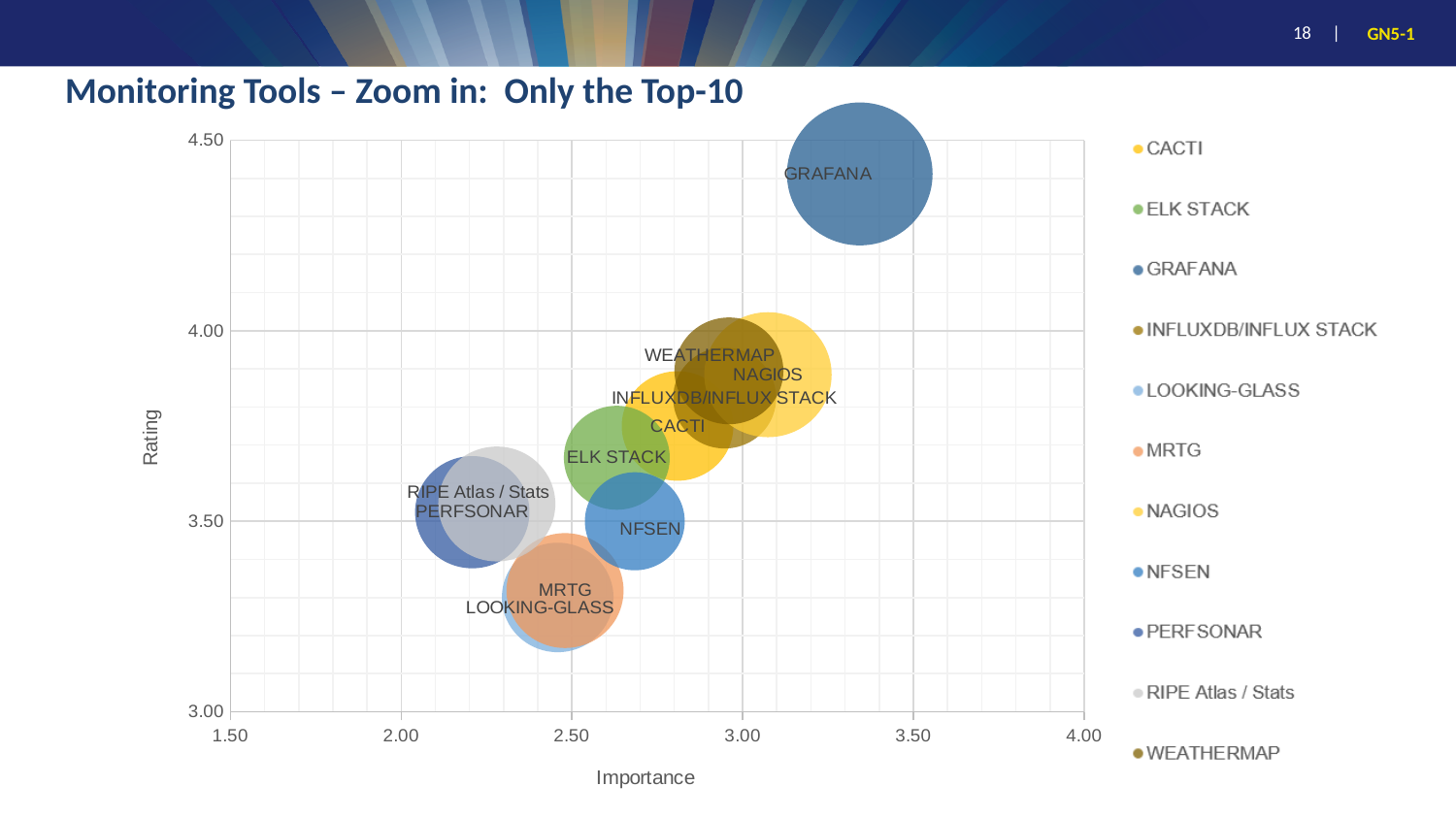
Is the Rating for GRAFANA greater or less than 4.00? greater What kind of chart is shown on the slide? Bubble chart Which tool has the highest Importance? GRAFANA What is the label of the vertical axis? Rating Which has the higher Rating, ELK STACK or NFSEN? ELK STACK How many series does the legend list? 11 Is the Rating for ELK STACK greater or less than 3.50? greater Is the Rating for MRTG greater or less than 3.50? less What is the title of the chart on the slide? Monitoring Tools – Zoom in: Only the Top-10 Which has the higher Importance, NAGIOS or PERFSONAR? NAGIOS Which tool has the highest Rating? GRAFANA